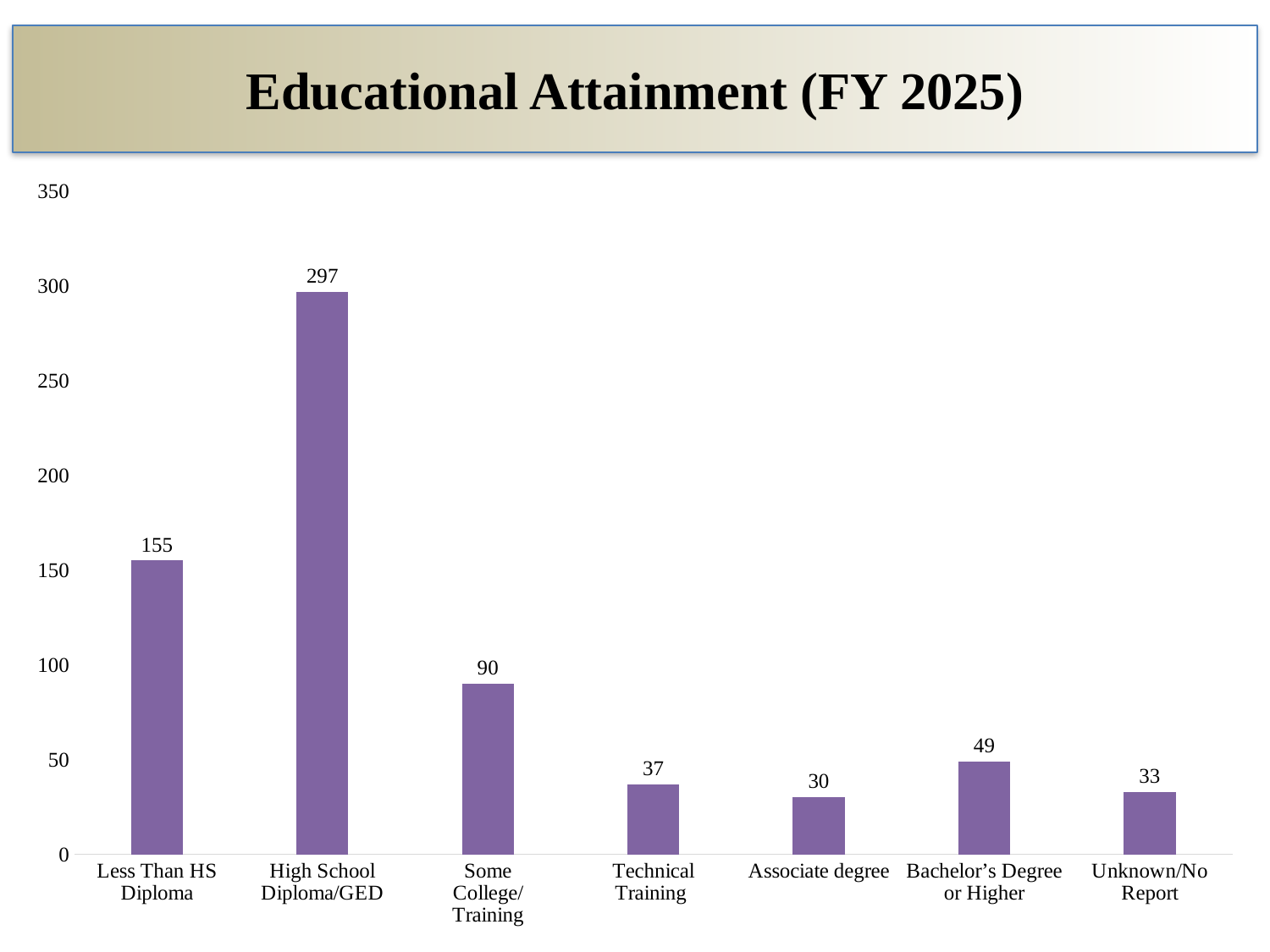
What is the title of the chart? Educational Attainment (FY 2025) What is the value for High School Diploma/GED? 297 Which category has the highest value? High School Diploma/GED What is the difference between the values for Technical Training and Associate degree? 7 What is the value for Bachelor's Degree or Higher? 49 Which category has the lowest value? Associate degree Which is larger, the value for Bachelor's Degree or Higher or the value for Unknown/No Report? Bachelor's Degree or Higher What kind of chart is shown on the slide? bar chart Is the value for Less Than HS Diploma greater or less than 100? greater How many categories are shown on the x axis? 7 What is the difference between the values for High School Diploma/GED and Less Than HS Diploma? 142 What is the value for Some College/Training? 90